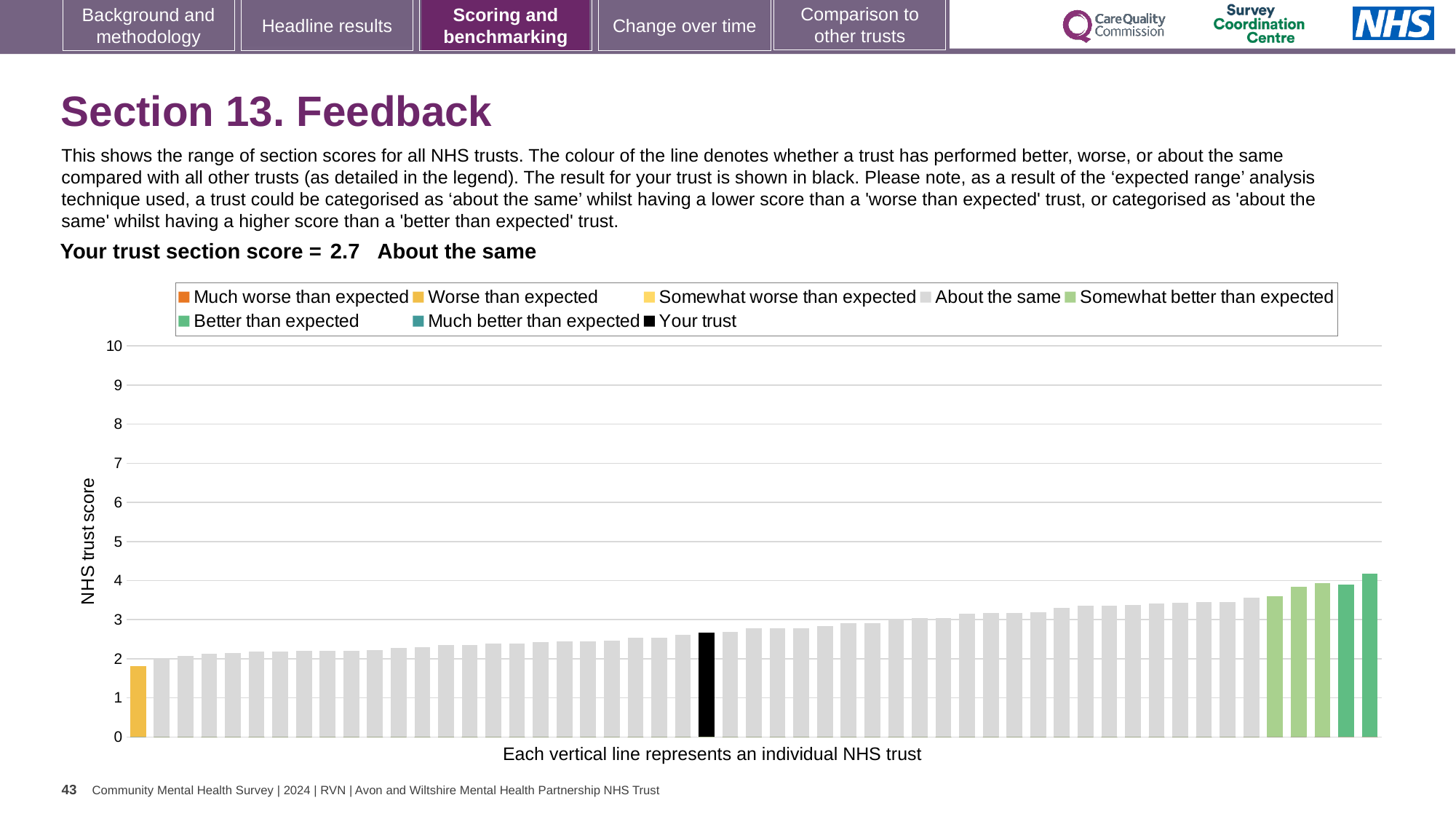
Which performance category does the lowest-scoring trust belong to? Worse than expected Which performance category does the highest-scoring trust belong to? Better than expected What colour is used for the bar representing your trust? Black Is the value for your trust (the black bar) greater or less than 3? less What type of chart is shown on the slide? Bar chart What is the label on the vertical axis of the chart? NHS trust score How many entries does the chart legend list? 8 Is the value of the lowest bar greater or less than 3? less What is the section score for your trust shown on the slide? 2.7 Which performance category is your trust placed in for Section 13? About the same Is the value of the highest bar greater or less than 3? greater Do the bar values rise or fall from left to right along the x axis? Rise